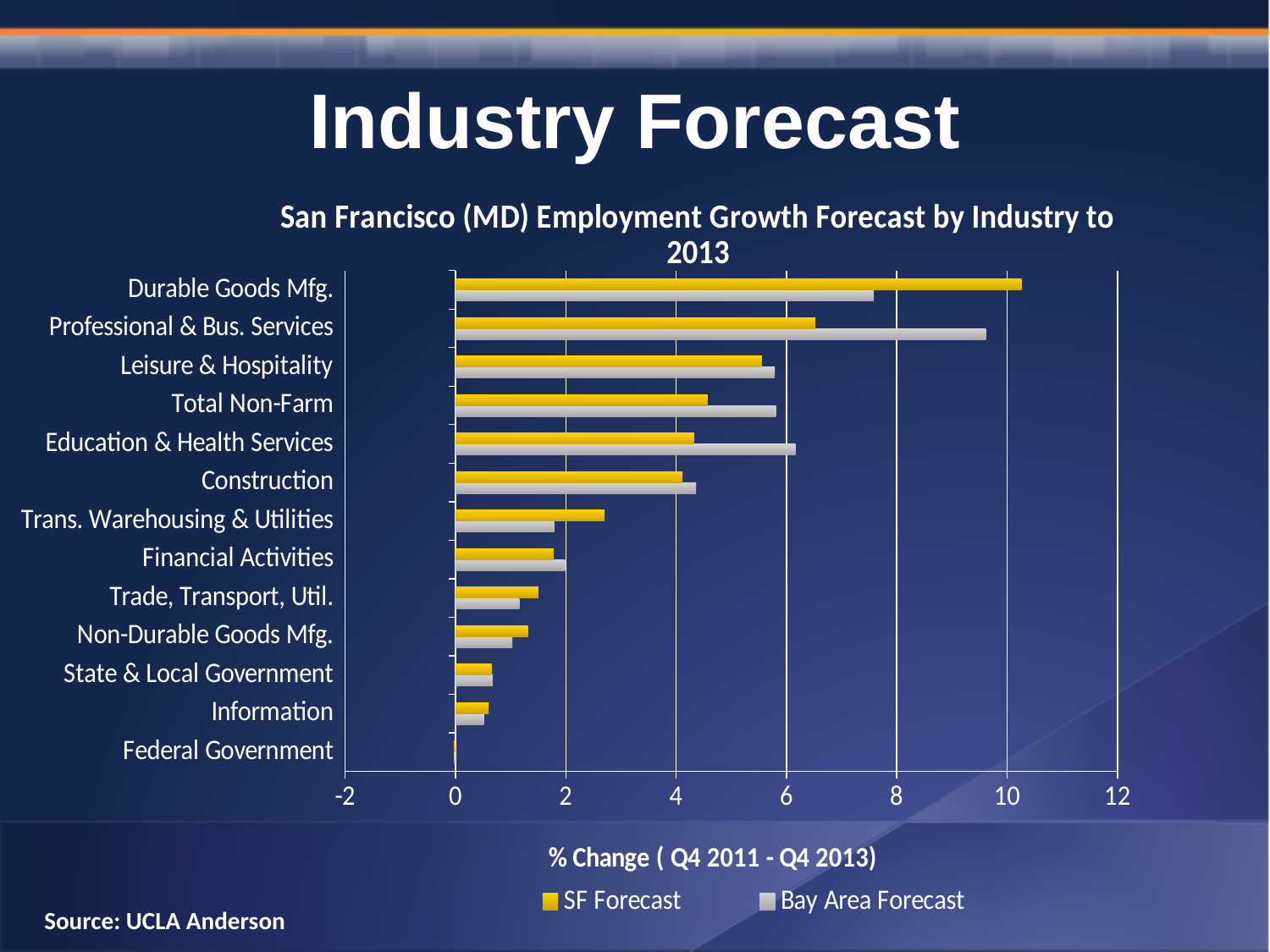
How many industries are listed on the chart? 13 Is the SF Forecast value for Trans. Warehousing & Utilities greater or less than 2? greater Which colour represents the SF Forecast series in the legend? yellow Which industry has the highest SF Forecast value? Durable Goods Mfg. Is the Bay Area Forecast value for Professional & Bus. Services greater or less than 8? greater Which industry has the highest Bay Area Forecast value? Professional & Bus. Services For Professional & Bus. Services, which is larger: the SF Forecast or the Bay Area Forecast? Bay Area Forecast What kind of chart is shown on the slide? bar chart Is the SF Forecast value for Leisure & Hospitality greater or less than 6? less How many series does the legend list? 2 Which industry has the lowest SF Forecast value? Federal Government